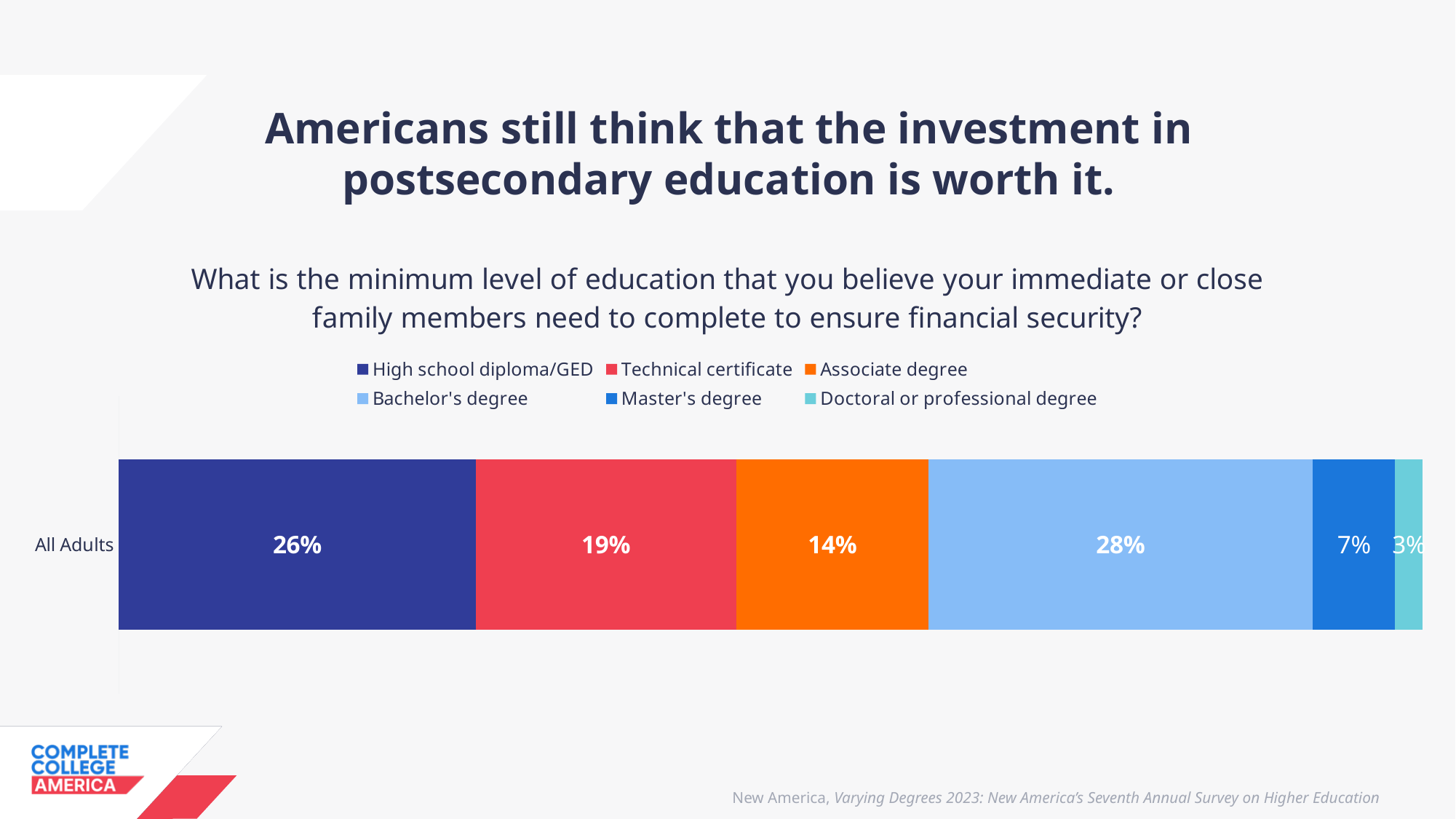
Which education level has the smallest share in the All Adults bar? Doctoral or professional degree What percentage of All Adults chose Bachelor's degree as the minimum level of education needed for financial security? 28% What kind of chart is shown on the slide? Stacked bar chart What is the value for High school diploma/GED in the All Adults bar? 26% What is the value for Technical certificate in the All Adults bar? 19% Which is larger for All Adults: High school diploma/GED or Technical certificate? High school diploma/GED What is the total of all segments in the All Adults bar? 97% What is the difference between the Bachelor's degree and Associate degree values for All Adults? 14% What is the value for Master's degree in the All Adults bar? 7% What colour is the Associate degree segment in the bar? Orange How many series does the legend list? 6 Which education level has the largest share in the All Adults bar? Bachelor's degree